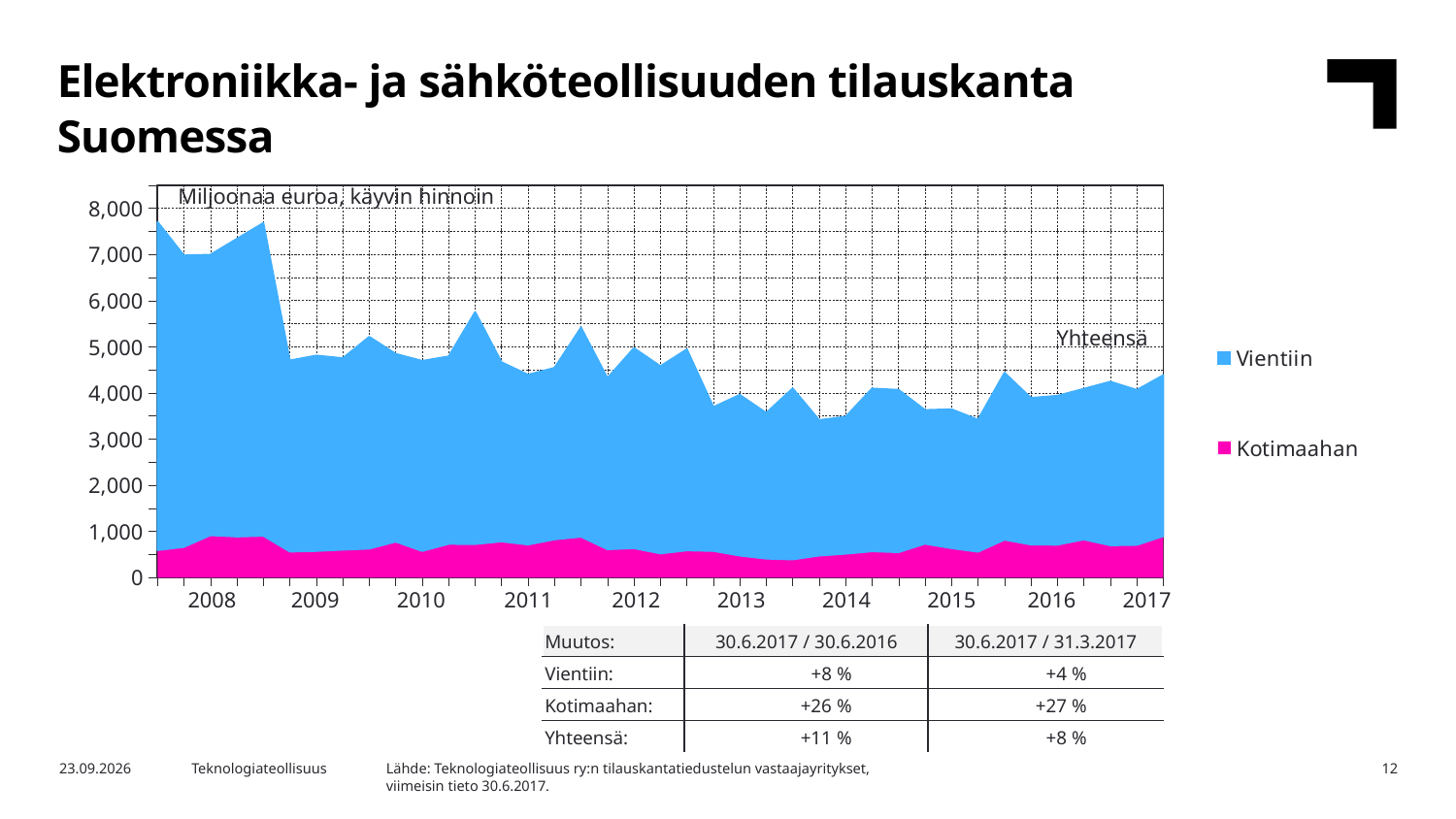
Is the total order stock (Yhteensä) at the end of 2017 greater or less than 5,000? less Is the total order stock (Yhteensä) in 2013 greater or less than 5,000? less Is the total order stock (Yhteensä) at the start of 2008 greater or less than 7,000? greater What is the highest value shown on the y axis of the chart? 8,000 What unit label is shown at the top of the chart? Miljoonaa euroa, käyvin hinnoin How many series does the chart legend list? 2 Overall, does the total order stock rise or fall from 2008 to 2017? fall Which two series are listed in the chart legend? Vientiin and Kotimaahan Which series is larger throughout the chart, Vientiin or Kotimaahan? Vientiin What kind of chart is shown on the slide? Stacked area chart How many years are labelled on the x axis of the chart? 10